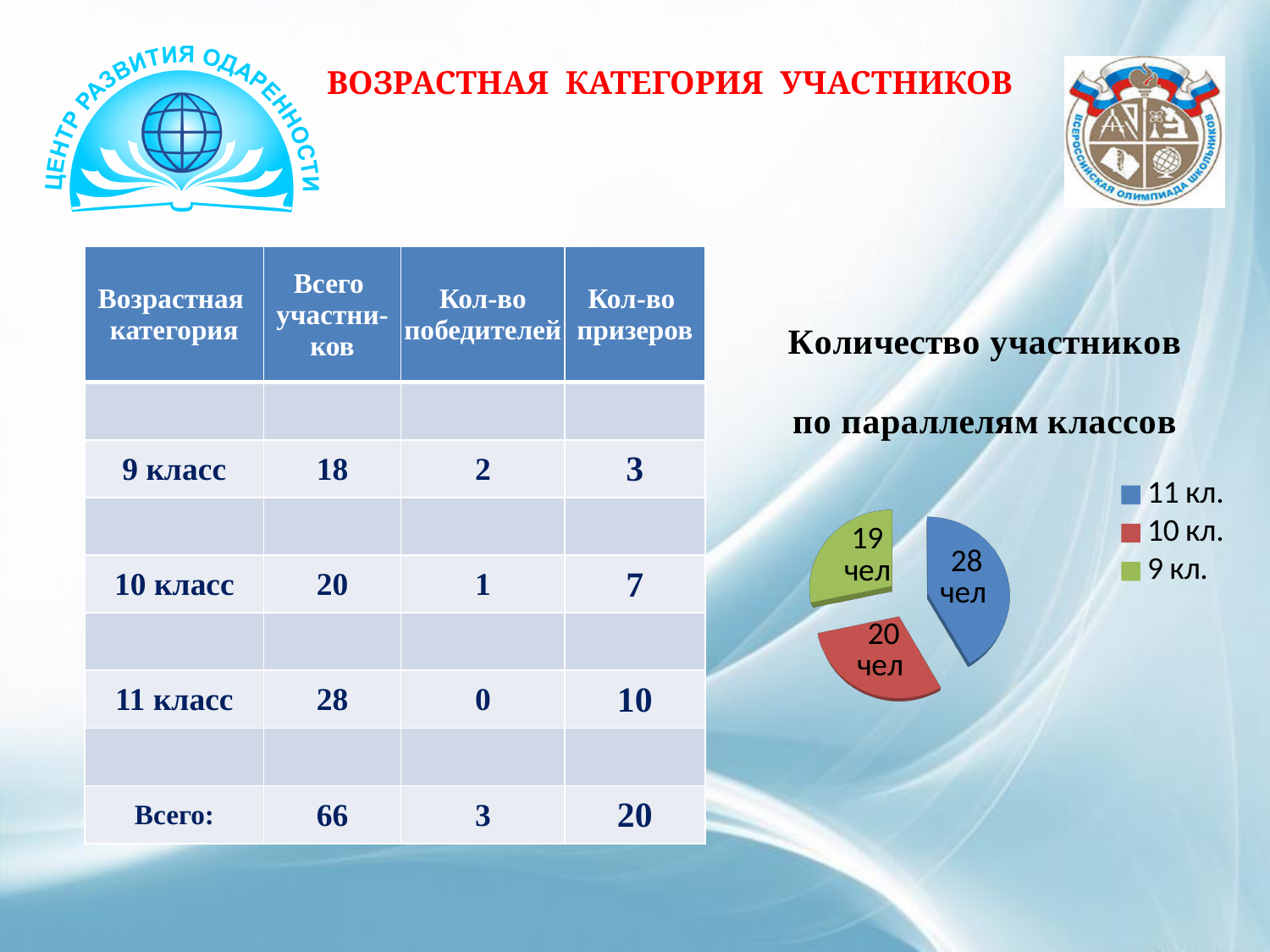
Which slice is larger in the pie chart, 10 кл. or 9 кл.? 10 кл. By how many people does the 11 кл. slice exceed the 10 кл. slice in the pie chart? 8 What kind of chart is shown on the slide? pie chart Which class has the smallest slice in the pie chart? 9 кл. What colour is the 11 кл. slice in the pie chart? blue What value is shown on the pie slice for 10 кл.? 20 чел What value is shown on the pie slice for 9 кл.? 19 чел How many entries does the chart legend list? 3 How many slices does the pie chart have? 3 What value is shown on the pie slice for 11 кл.? 28 чел Which class has the largest slice in the pie chart? 11 кл. What is the title of the chart? Количество участников по параллелям классов